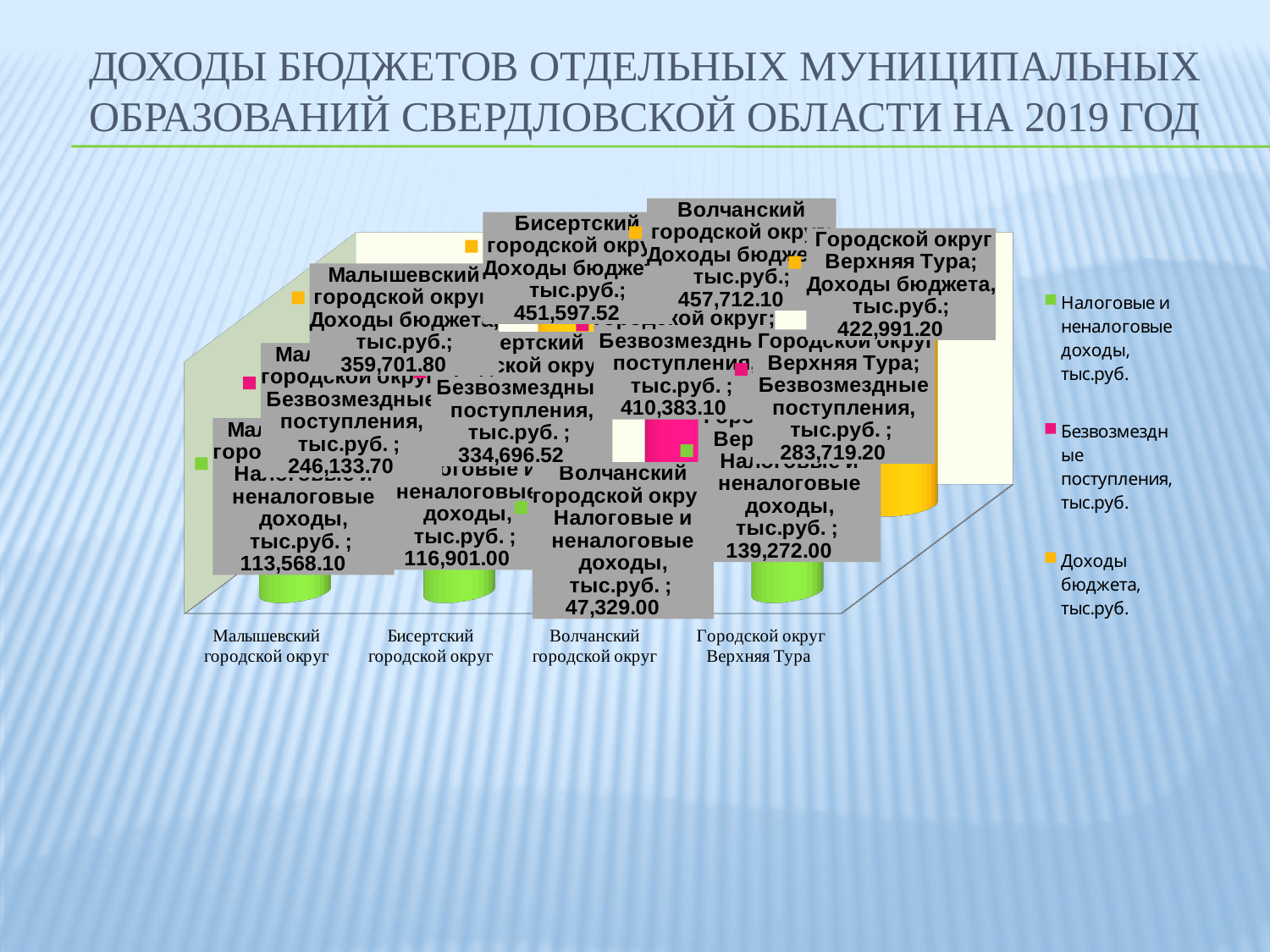
Which colour represents Доходы бюджета in the legend? Yellow How many series does the legend list? 3 What is the value of Безвозмездные поступления for Городской округ Верхняя Тура? 283,719.20 What is the value of Безвозмездные поступления for Бисертский городской округ? 334,696.52 What is the value of Доходы бюджета for Волчанский городской округ? 457,712.10 Which is larger: Безвозмездные поступления for Волчанский городской округ or for Городской округ Верхняя Тура? Волчанский городской округ Which municipality has the highest Доходы бюджета? Волчанский городской округ Which municipality has the lowest Налоговые и неналоговые доходы? Волчанский городской округ What is the value of Налоговые и неналоговые доходы for Малышевский городской округ? 113,568.10 What is the difference between Доходы бюджета for Бисертский городской округ and Малышевский городской округ? 91,895.72 How many municipalities are shown on the x axis? 4 What kind of chart is shown on the slide? Bar chart